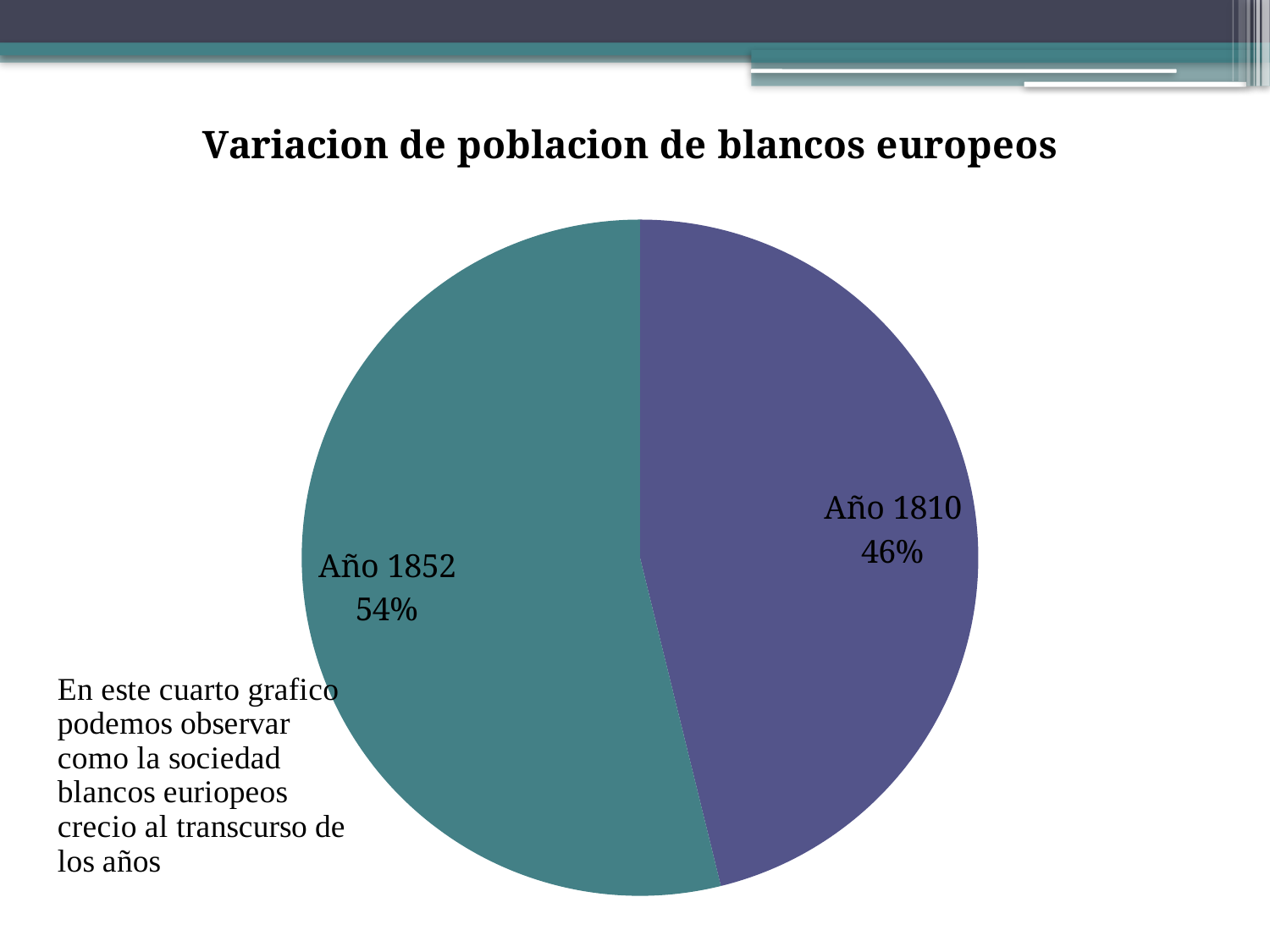
What colour is the Año 1810 slice? Purple What kind of chart is shown on the slide? Pie chart What share of the pie does Año 1852 represent? 54% Which slice is the smallest in the pie chart? Año 1810 What is the title of the chart? Variacion de poblacion de blancos europeos What is the difference in percentage points between the Año 1852 and Año 1810 slices? 8 How many slices does the pie chart have? 2 Which slice is the largest in the pie chart? Año 1852 Which slice is larger, Año 1810 or Año 1852? Año 1852 Is the share for Año 1810 greater or less than 50%? less Is the share for Año 1852 greater or less than 50%? greater What share of the pie does Año 1810 represent? 46%